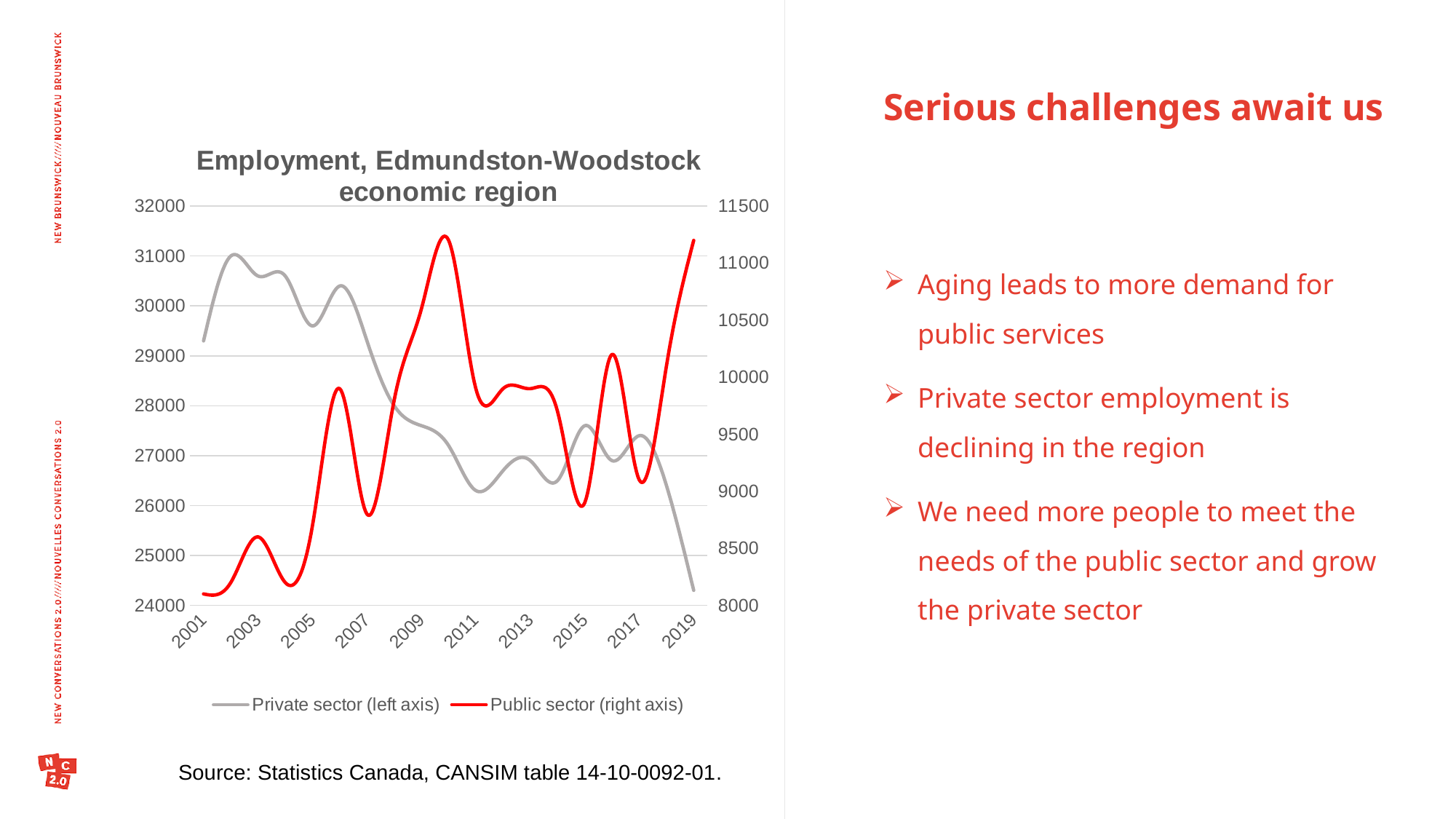
Is the Private sector value in 2011 greater or less than 27000? less Is the Public sector value in 2001 greater or less than 8500? less Overall, does Private sector employment rise or fall from 2001 to 2019? Fall How many series does the legend list? 2 Is the Public sector value in 2019 greater or less than 11000? greater Overall, does Public sector employment rise or fall from 2001 to 2019? Rise Which axis does the Public sector series use, according to the legend? Right axis What kind of chart is shown on the slide? Line chart What is the title of the chart? Employment, Edmundston-Woodstock economic region